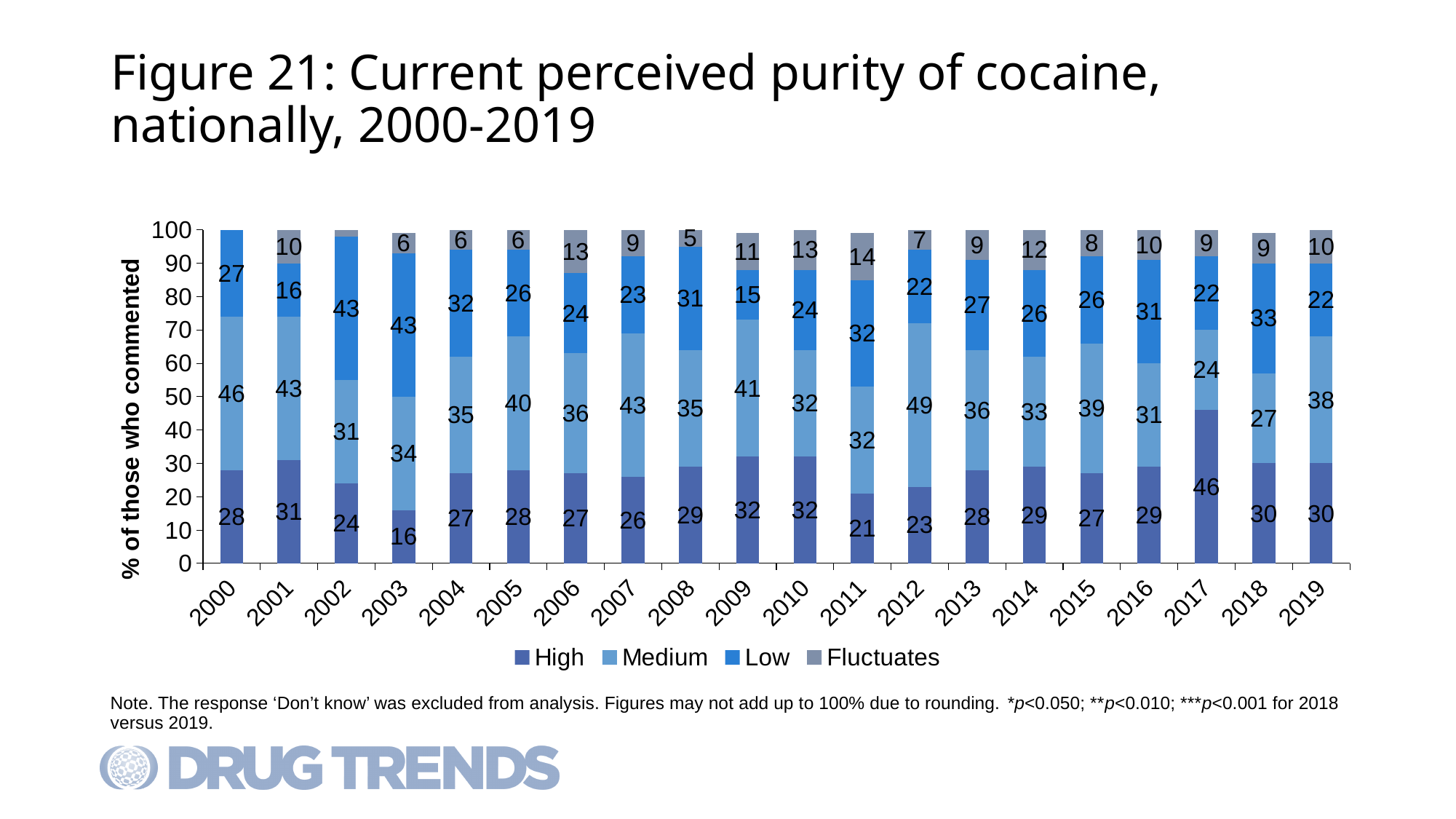
What is the value for Low in 2002? 43 What is the difference between the Medium value in 2019 and the Medium value in 2018? 11 What is the value for Medium in 2012? 49 In which year is the High value the lowest? 2003 What kind of chart is shown on the slide? Stacked bar chart What is the value for High in 2017? 46 How many years are shown on the x axis? 20 What is the label of the y axis? % of those who commented How many series does the legend list? 4 Which is larger, the Low value in 2018 or the Low value in 2019? 2018 In which year is the High value the highest? 2017 What is the value for Fluctuates in 2011? 14